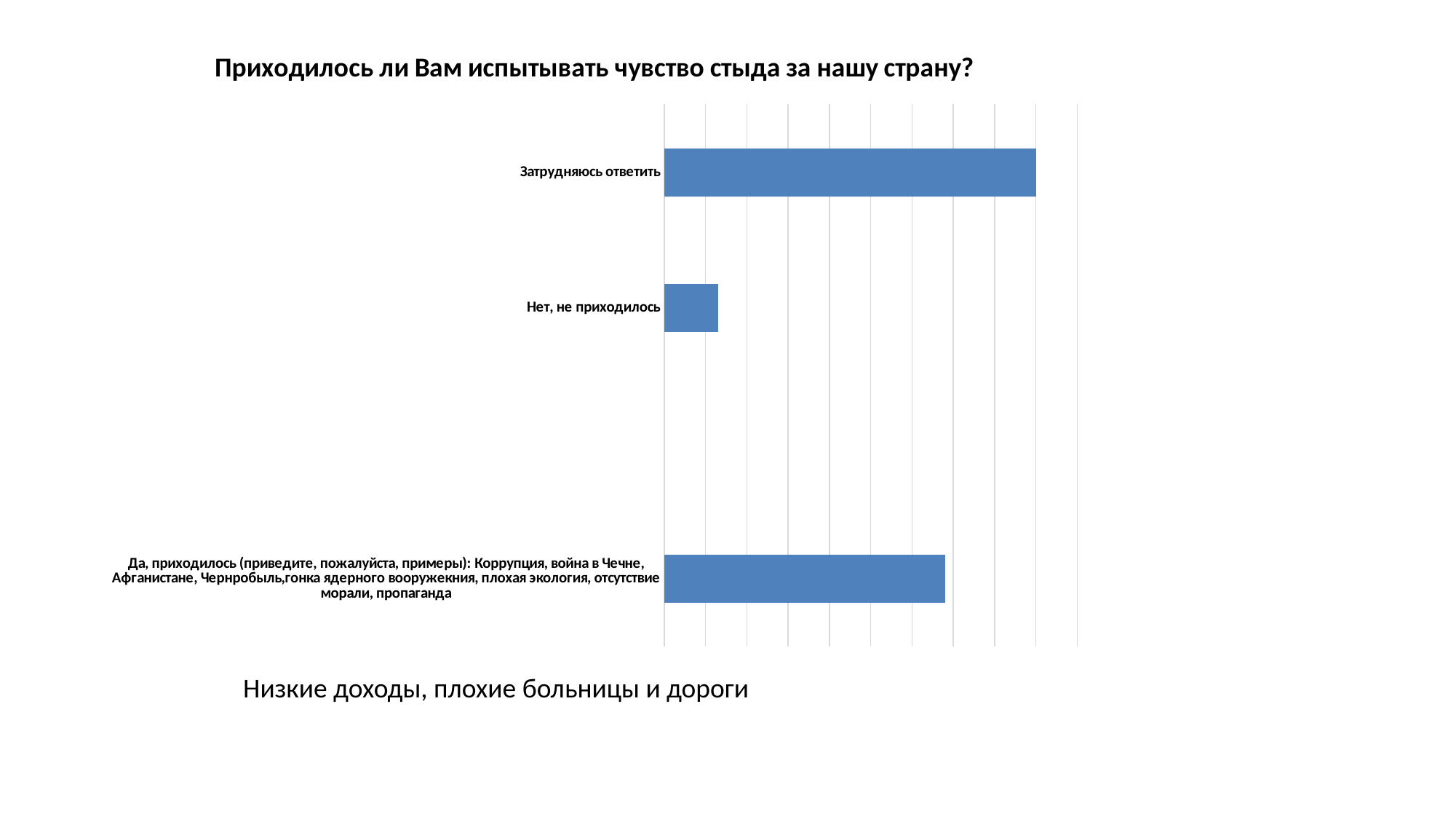
Which category has the lowest value in the chart? Нет, не приходилось Are the bars in the chart drawn horizontally or vertically? Horizontally Which is larger: the value for "Затрудняюсь ответить" or the value for "Да, приходилось"? Затрудняюсь ответить Which category has the highest value in the chart? Затрудняюсь ответить What kind of chart is shown on the slide? Bar chart Which category has the second-longest bar in the chart? Да, приходилось Which is larger: the value for "Нет, не приходилось" or the value for "Да, приходилось"? Да, приходилось What is the title of the chart? Приходилось ли Вам испытывать чувство стыда за нашу страну? How many categories (bars) does the chart show? 3